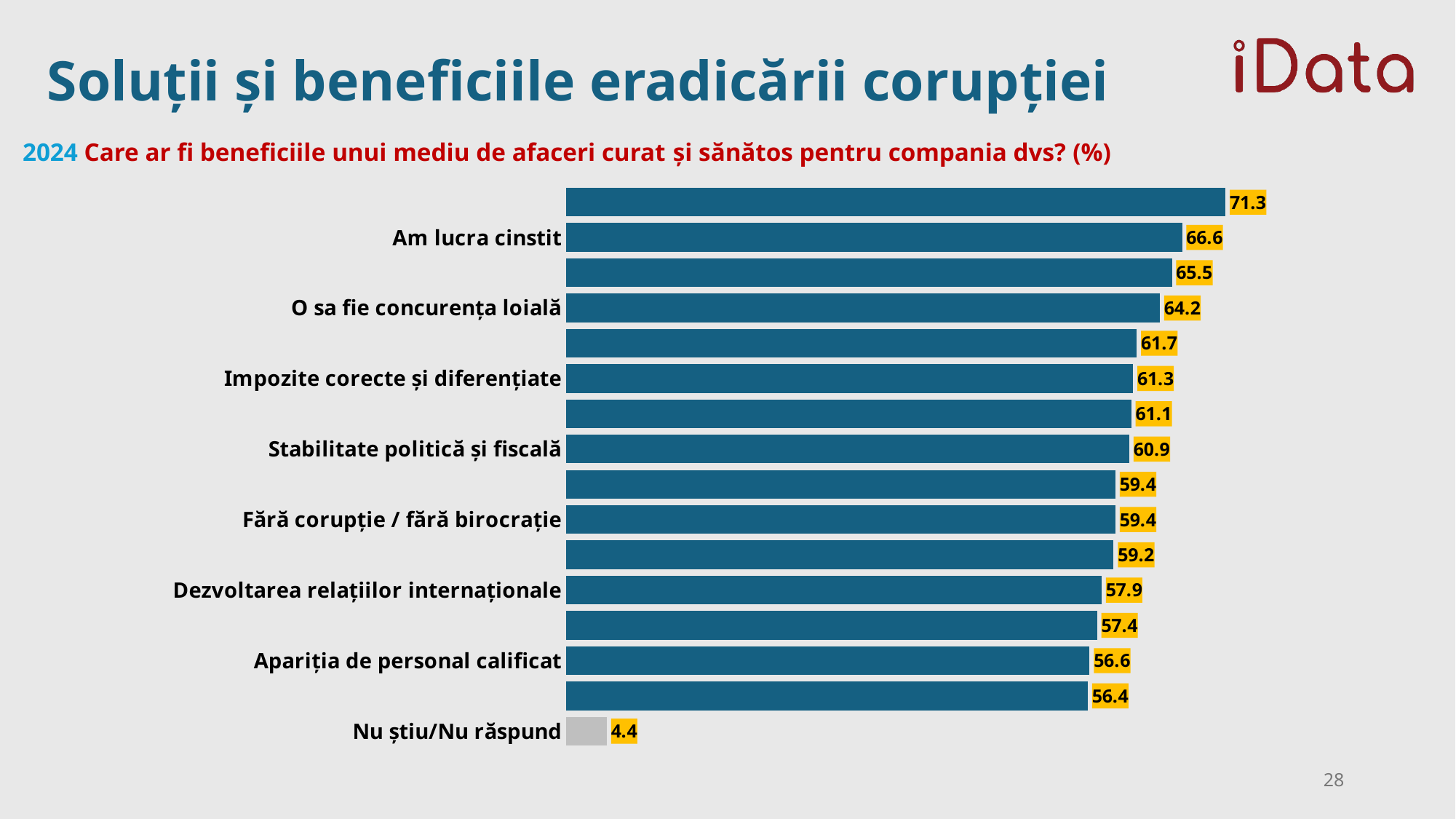
What is the value for "Nu știu/Nu răspund"? 4.4 What is the value for "Am lucra cinstit"? 66.6 How many bars are plotted on the chart? 16 What is the highest value shown on the chart? 71.3 What is the value for "Stabilitate politică și fiscală"? 60.9 What is the value for "Impozite corecte și diferențiate"? 61.3 What type of chart is shown on the slide? Bar chart What is the value for "Dezvoltarea relațiilor internaționale"? 57.9 What is the difference between the values for "Am lucra cinstit" and "Apariția de personal calificat"? 10.0 Which is larger, the value for "O sa fie concurența loială" or the value for "Fără corupție / fără birocrație"? O sa fie concurența loială What is the value for "O sa fie concurența loială"? 64.2 Which category has the lowest value? Nu știu/Nu răspund